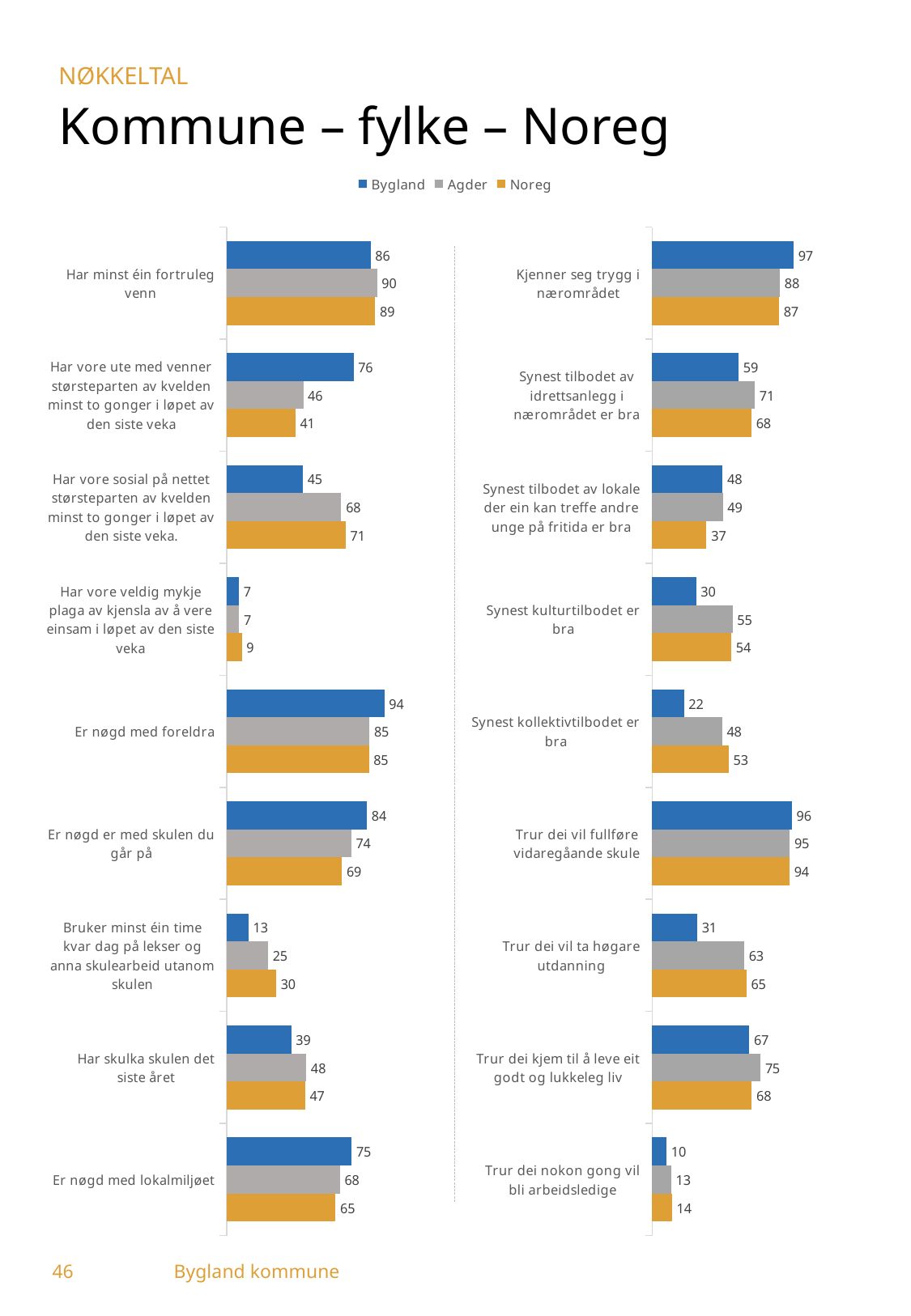
In the right chart, what is the difference between the Agder and Bygland values for "Synest kulturtilbodet er bra"? 25 In the left chart, for "Har skulka skulen det siste året", which is larger: the Agder value or the Bygland value? Agder In the left chart, what is the Bygland value for "Er nøgd med foreldra"? 94 How many categories does the left chart show? 9 In the right chart, what is the Agder value for "Trur dei vil ta høgare utdanning"? 63 In the left chart, what is the difference between the Bygland and Noreg values for "Har vore ute med venner størsteparten av kvelden minst to gonger i løpet av den siste veka"? 35 How many series does the legend list? 3 In the right chart, which category has the lowest Bygland value? Trur dei nokon gong vil bli arbeidsledige In the right chart, for "Kjenner seg trygg i nærområdet", which is larger: the Bygland value or the Noreg value? Bygland In the left chart, which category has the highest Bygland value? Er nøgd med foreldra In the right chart, what is the Noreg value for "Synest kollektivtilbodet er bra"? 53 What kind of chart is the right chart? Bar chart